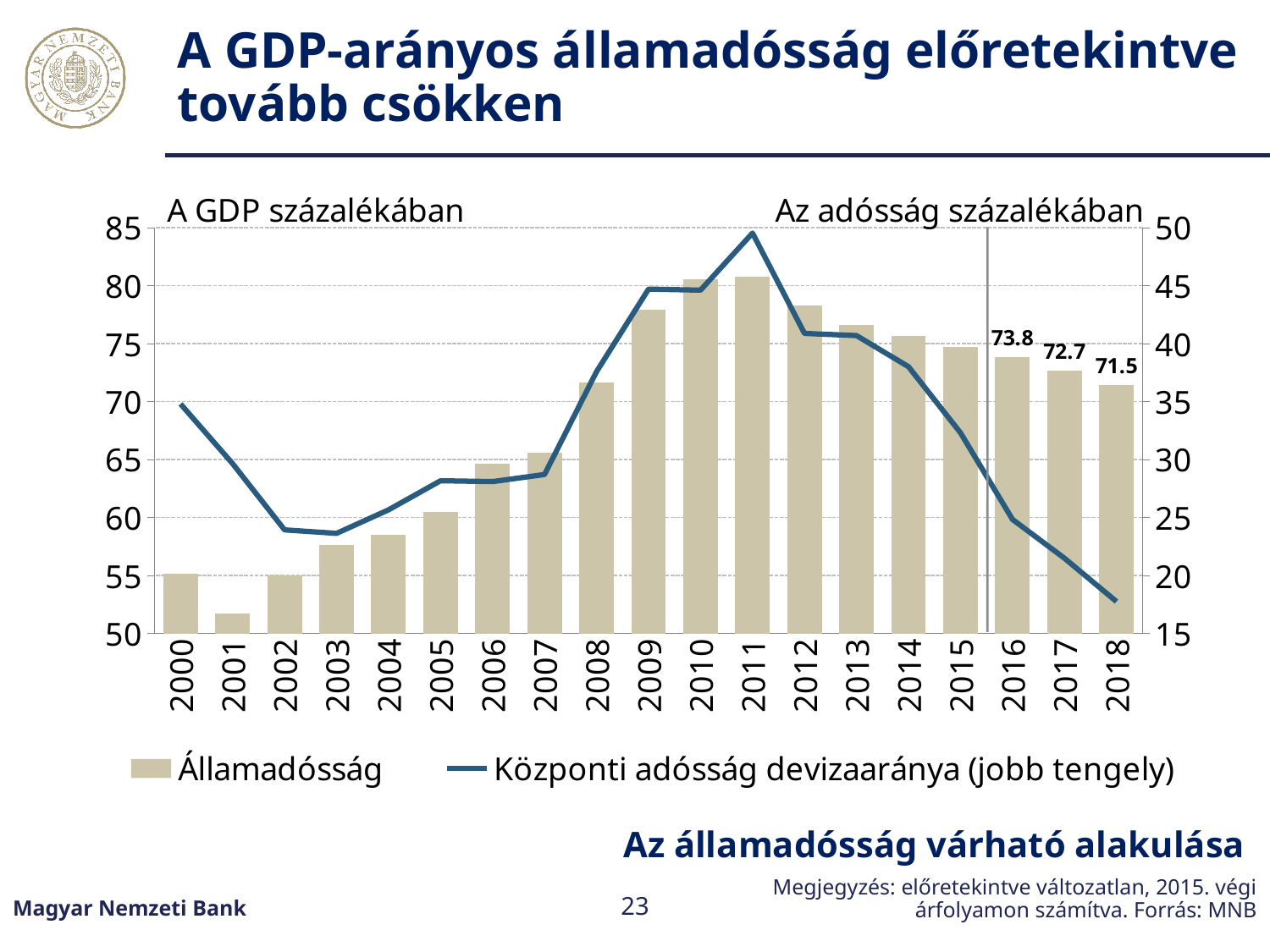
How many series does the legend list? 2 Is the Központi adósság devizaaránya value for 2018 greater or less than 20 on the right axis? less How many years are shown on the x axis? 19 Which year has the lowest Államadósság bar? 2001 Do the Államadósság bars rise or fall from 2015 to 2018? fall Is the Államadósság value for 2001 greater or less than 55? less What is the value of the Államadósság bar for 2016? 73.8 What is the value of the Államadósság bar for 2017? 72.7 What is the value of the Államadósság bar for 2018? 71.5 Which series is plotted on the right axis according to the legend? Központi adósság devizaaránya By how much does the Államadósság value fall from 2016 to 2018? 2.3 In which year does the Központi adósság devizaaránya line reach its highest point? 2011